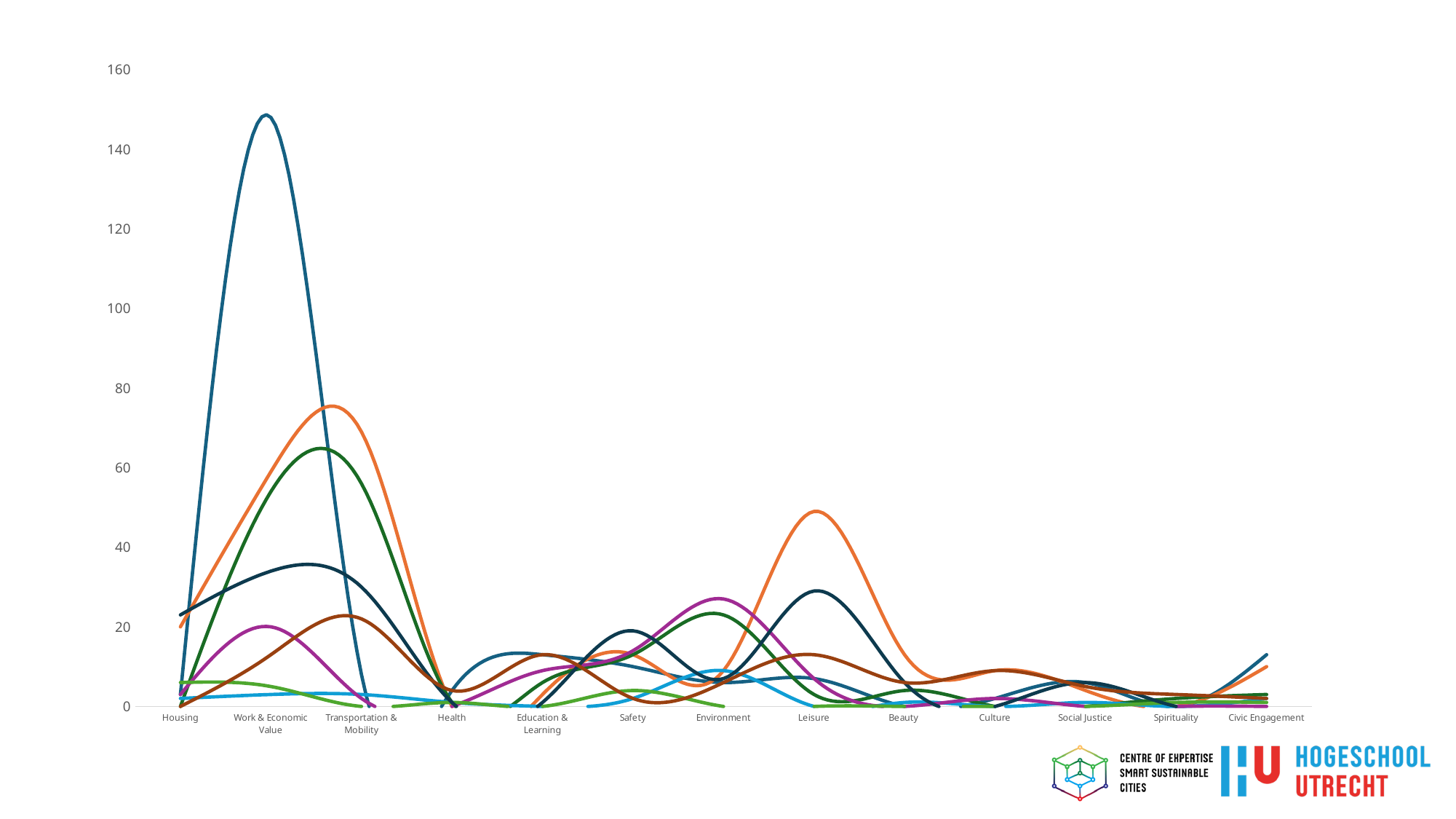
Is the value of the orange line at Leisure greater or less than 60? less How many categories are listed along the x axis of the chart? 13 At Leisure, which line is higher: the orange line or the dark navy line? the orange line What kind of chart is shown on the slide? line chart At which category does the highest peak of any line occur? Work & Economic Value Is the highest value plotted on the chart greater or less than 140? greater What is the highest tick value shown on the y axis? 160 Is the value of the tallest line at Work & Economic Value greater or less than 100? greater What is the first category on the x axis? Housing